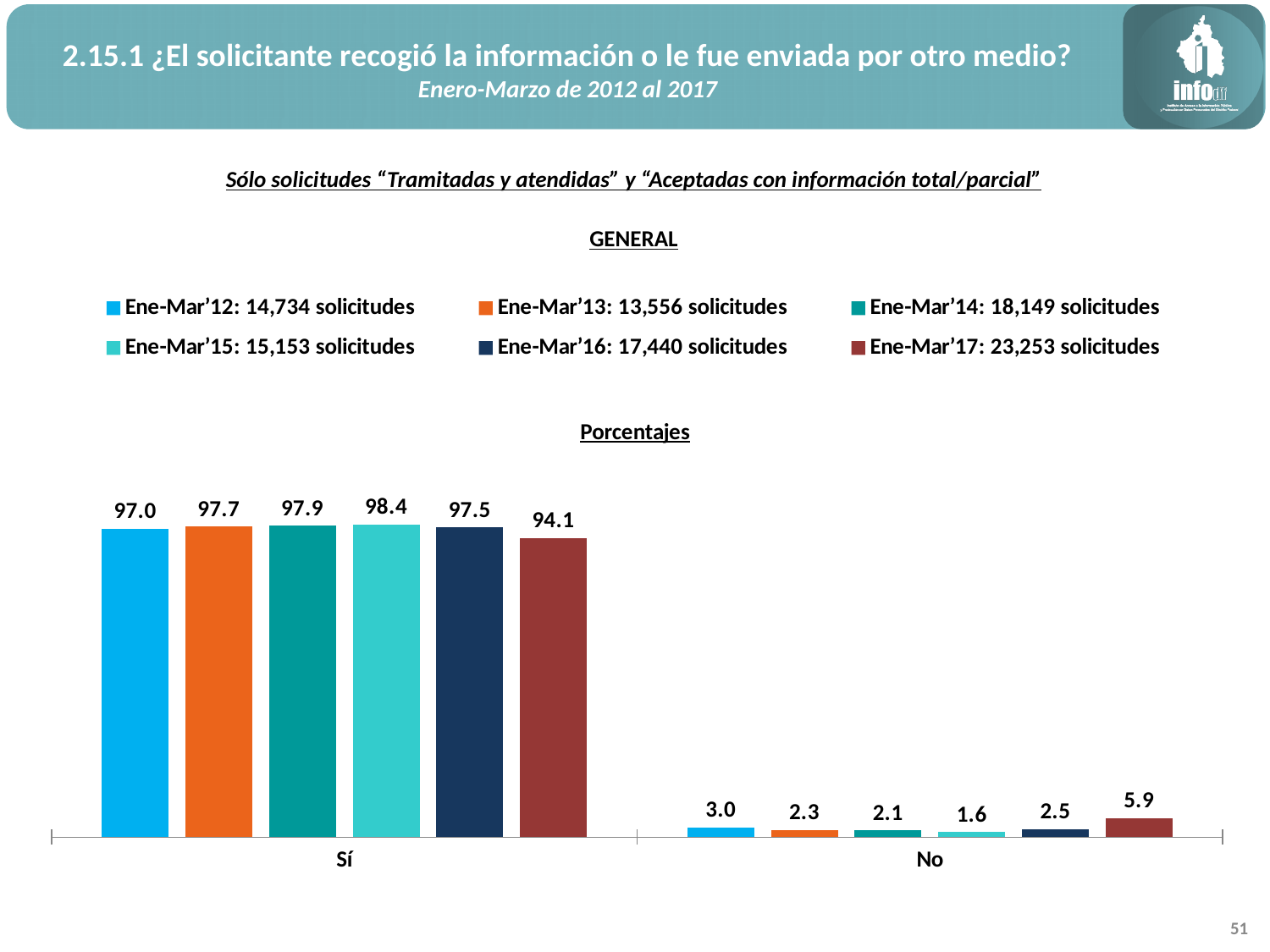
What is the difference between the Ene-Mar'15 and Ene-Mar'17 values in the Sí category? 4.3 According to the legend, how many solicitudes does the Ene-Mar'17 series represent? 23,253 solicitudes What is the value for Ene-Mar'12 in the Sí category? 97.0 Which is larger in the Sí category: Ene-Mar'13 or Ene-Mar'17? Ene-Mar'13 What is the difference between the Ene-Mar'17 and Ene-Mar'12 values in the No category? 2.9 How many series does the legend list? 6 What is the value for Ene-Mar'17 in the No category? 5.9 What kind of chart is shown on the slide? bar chart Which series has the highest value in the Sí category? Ene-Mar'15: 15,153 solicitudes Which series has the lowest value in the No category? Ene-Mar'15: 15,153 solicitudes How many categories are shown on the x axis? 2 What is the value for Ene-Mar'15 in the Sí category? 98.4